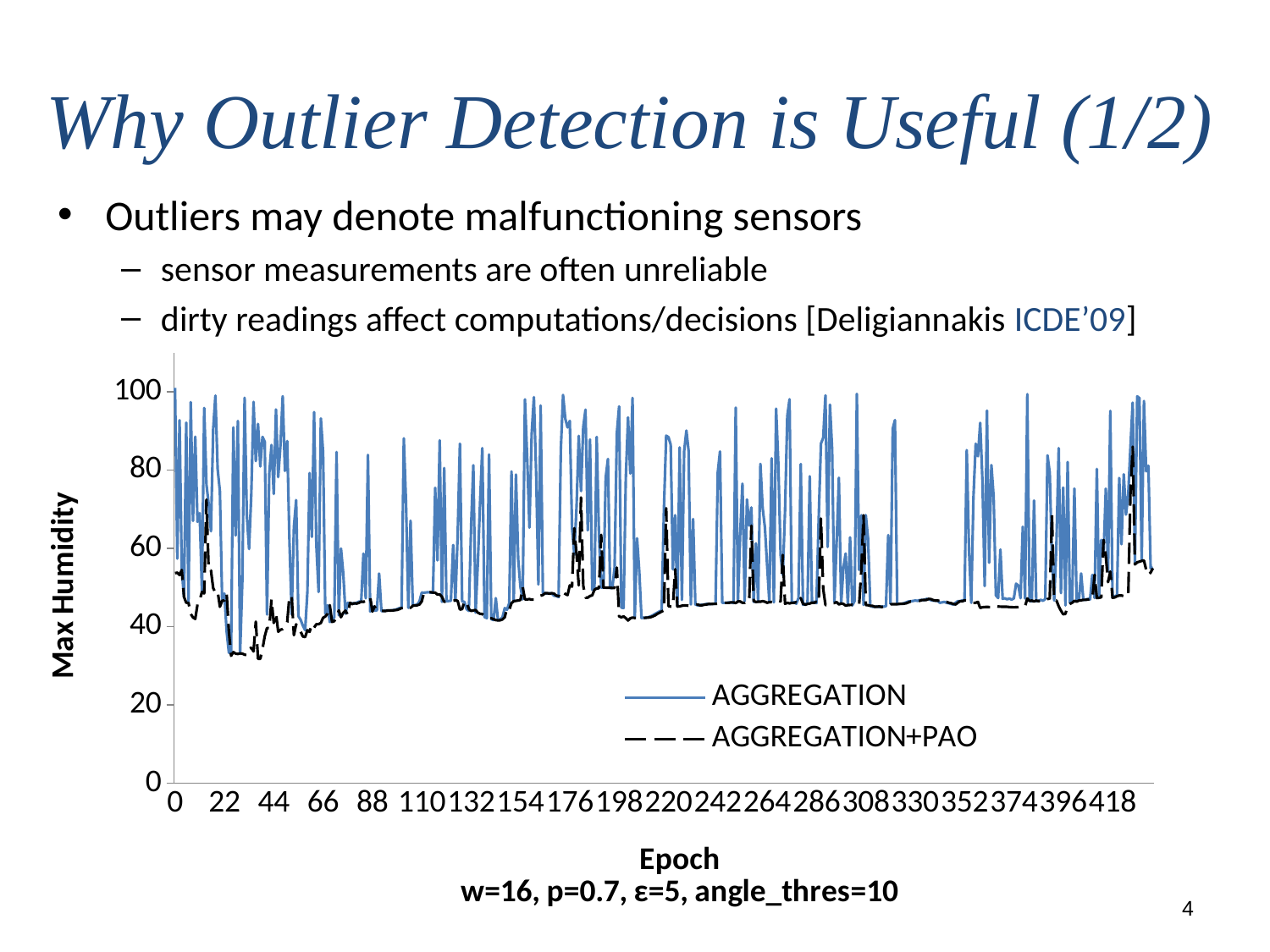
What is the last tick value shown on the horizontal axis? 418 What kind of chart is shown on the slide? line chart What is the highest tick value shown on the vertical axis? 100 How many series does the chart's legend list? 2 Which series is drawn with a dashed line? AGGREGATION+PAO Is the AGGREGATION+PAO value at epoch 330 greater or less than 60? less Is the AGGREGATION+PAO value at epoch 22 greater or less than 60? less Which series reaches higher peak values overall, AGGREGATION or AGGREGATION+PAO? AGGREGATION